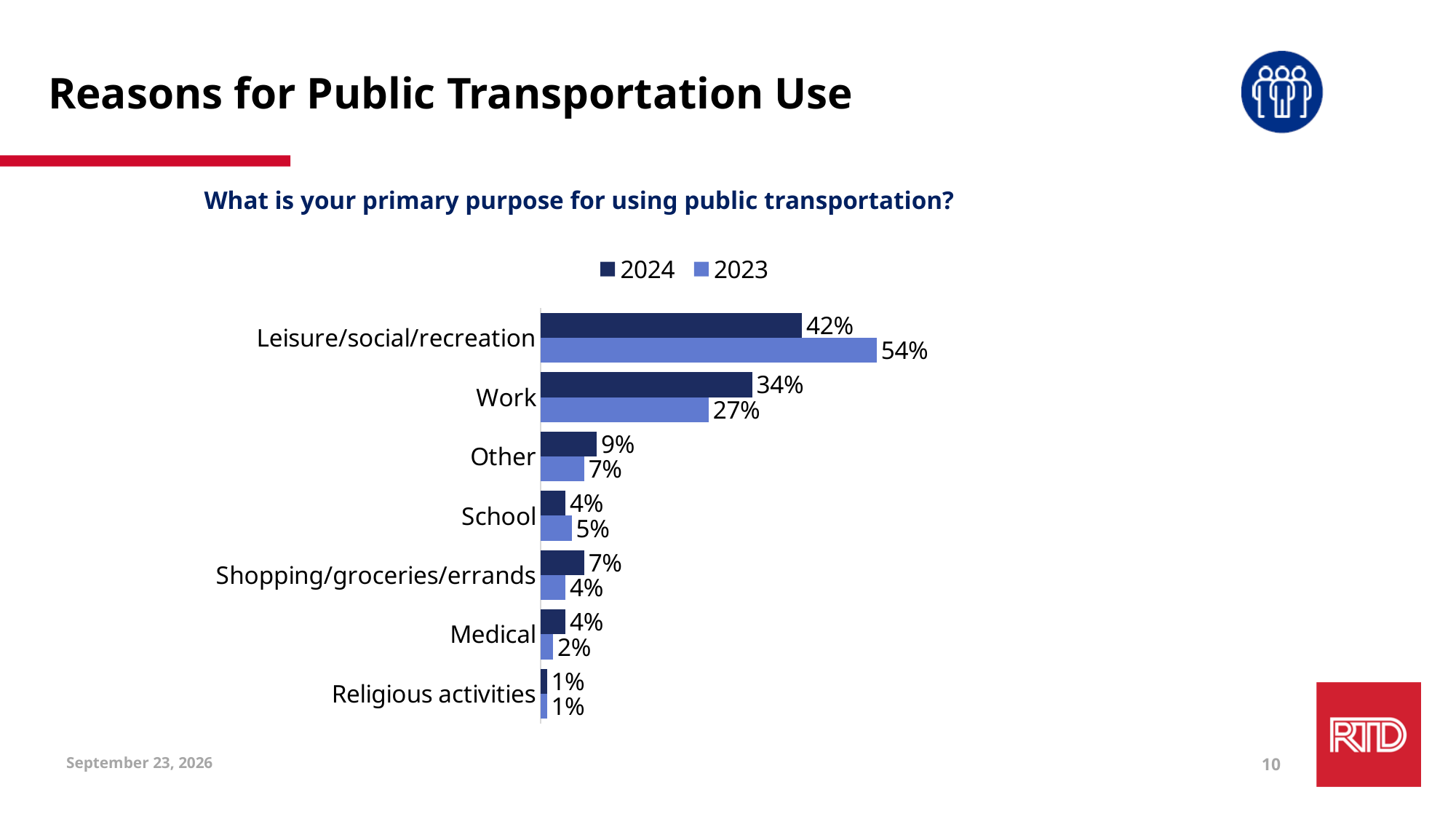
What kind of chart is shown on the slide? Bar chart What is the 2023 value for Medical? 2% How many categories are shown in the chart? 7 What is the difference between the 2024 and 2023 values for Work? 7% Which is larger for School: the 2024 value or the 2023 value? 2023 What is the 2023 value for Work? 27% How many series does the legend list? 2 Which category has the highest 2023 value? Leisure/social/recreation What is the 2024 value for Shopping/groceries/errands? 7% Which category has the lowest 2024 value? Religious activities What is the 2024 value for Leisure/social/recreation? 42% What is the difference between the 2023 and 2024 values for Leisure/social/recreation? 12%